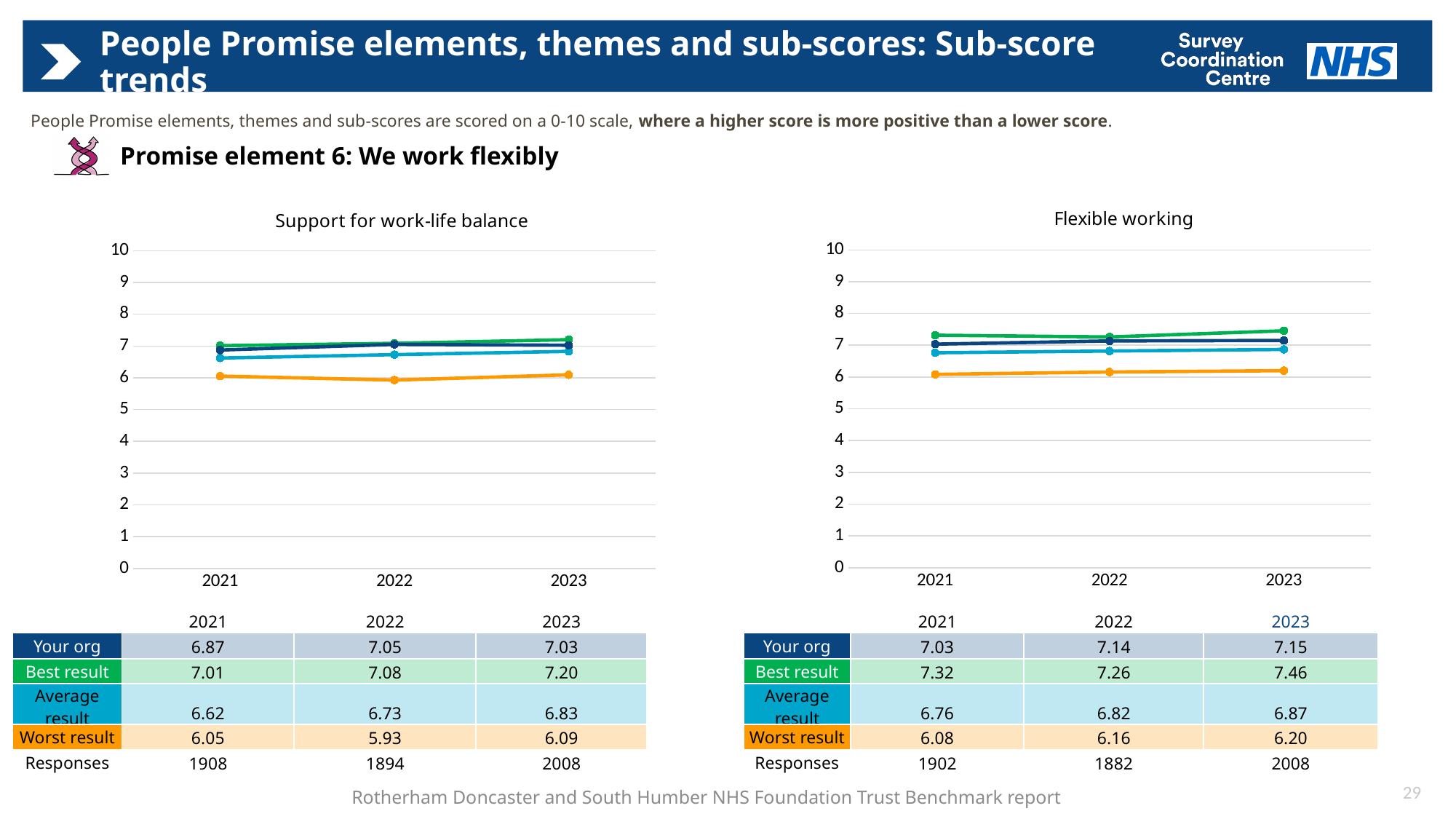
How many series are plotted in the 'Flexible working' chart? 4 In the 'Support for work-life balance' chart, what is the 'Your org' value for 2022? 7.05 How many years are plotted on the x axis of the 'Support for work-life balance' chart? 3 In the 'Flexible working' chart, which year has the lowest 'Worst result' value? 2021 In the 'Support for work-life balance' chart, which year has the highest 'Best result' value? 2023 In the 'Flexible working' chart, what is the 'Best result' value for 2023? 7.46 What kind of chart is the 'Support for work-life balance' chart? Line chart In the 'Flexible working' chart, which is larger in 2022: the 'Your org' value or the 'Average result' value? Your org In the 'Flexible working' chart, what is the 'Average result' value for 2021? 6.76 In the 'Flexible working' chart, is the 'Worst result' value for 2023 greater or less than 7? less In the 'Support for work-life balance' chart, what is the difference between the 'Best result' and 'Your org' values in 2023? 0.17 In the 'Support for work-life balance' chart, what is the 'Worst result' value for 2022? 5.93